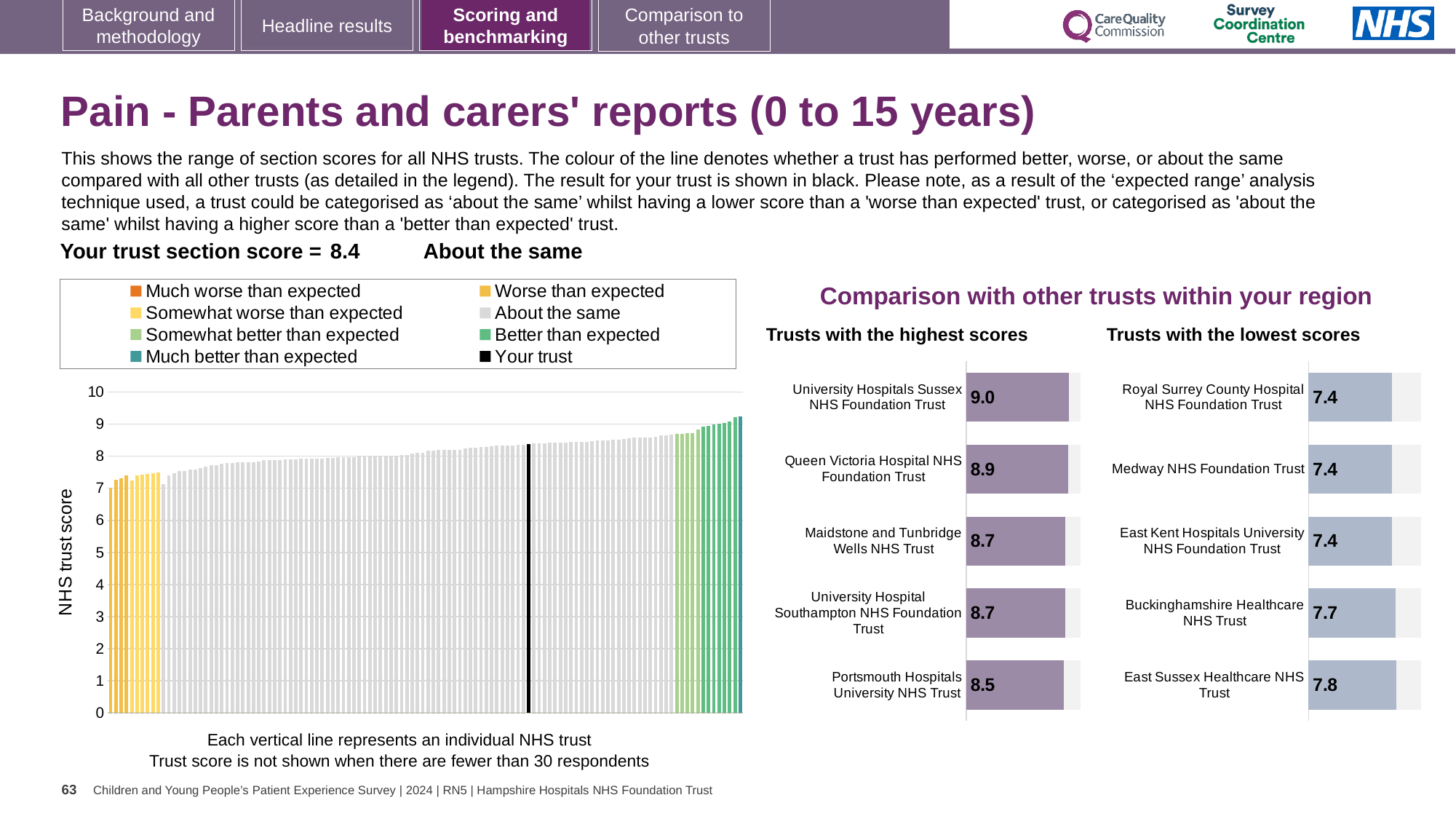
In the 'Trusts with the highest scores' chart, which trust has the highest score? University Hospitals Sussex NHS Foundation Trust In the 'Trusts with the lowest scores' chart, which trust has the highest score? East Sussex Healthcare NHS Trust How many trusts are shown in the 'Trusts with the highest scores' chart? 5 In the 'Trusts with the highest scores' chart, what is the score for Portsmouth Hospitals University NHS Trust? 8.5 In the 'Trusts with the lowest scores' chart, what is the score for Buckinghamshire Healthcare NHS Trust? 7.7 In the 'Trusts with the lowest scores' chart, what is the difference between the scores of East Sussex Healthcare NHS Trust and Medway NHS Foundation Trust? 0.4 What kind of chart is the main chart on the left showing the range of section scores for all NHS trusts? Bar chart In the 'Trusts with the highest scores' chart, what is the difference between the scores of University Hospitals Sussex NHS Foundation Trust and Portsmouth Hospitals University NHS Trust? 0.5 In the 'Trusts with the lowest scores' chart, which has the larger score: Buckinghamshire Healthcare NHS Trust or East Sussex Healthcare NHS Trust? East Sussex Healthcare NHS Trust In the 'Trusts with the highest scores' chart, what is the score for University Hospitals Sussex NHS Foundation Trust? 9.0 In the main chart on the left showing the range of section scores, is the value for the leftmost bar greater or less than 8? less How many entries does the legend of the main chart on the left list? 8